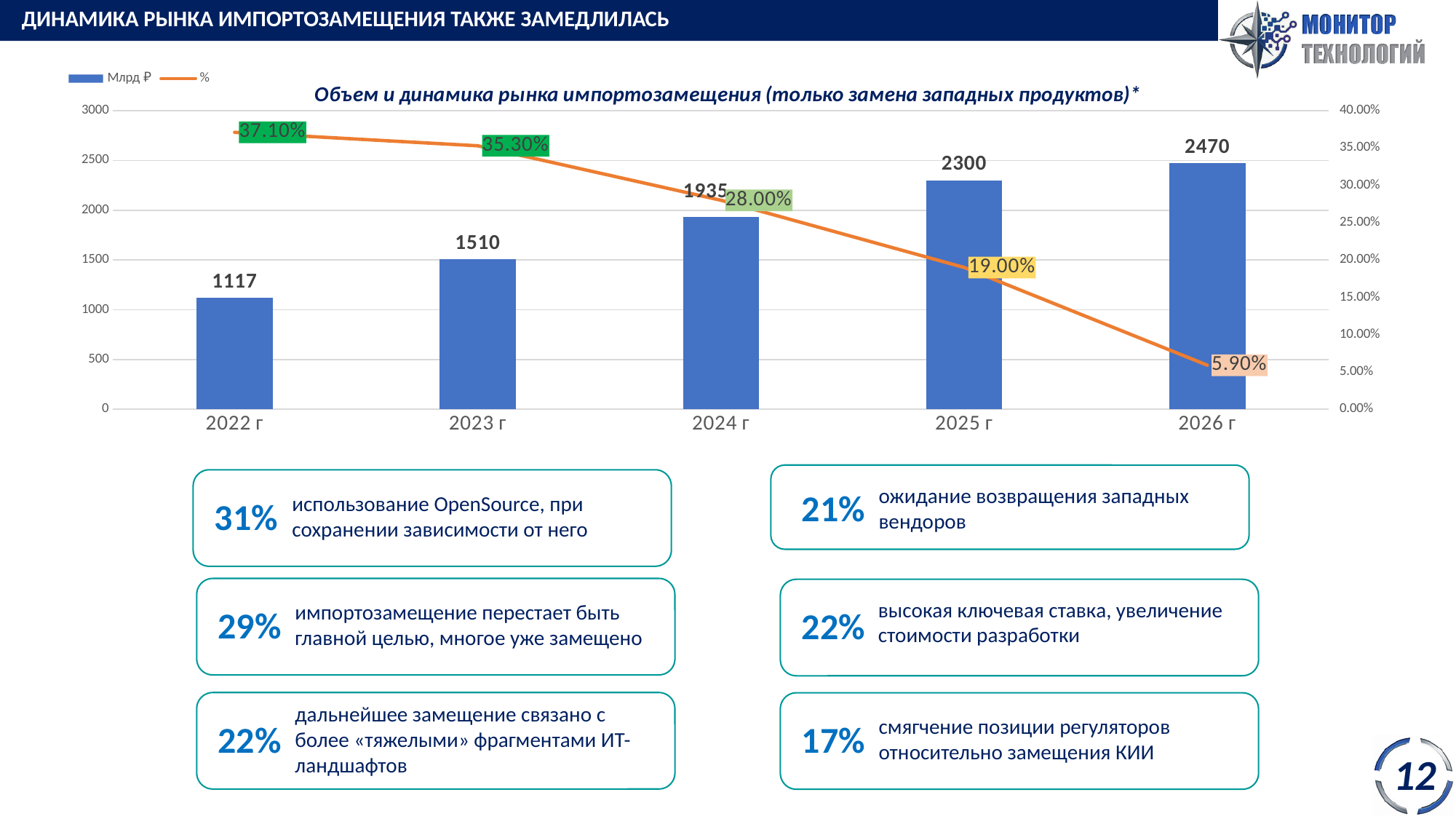
How many years are shown on the x axis? 5 What is the value of the Млрд ₽ bar for 2024 г? 1935 What is the title of the chart? Объем и динамика рынка импортозамещения (только замена западных продуктов)* What percentage does the % line show for 2026 г? 5.90% What is the difference between the Млрд ₽ values for 2025 г and 2023 г? 790 What percentage does the % line show for 2025 г? 19.00% Which year has the lowest value on the % line? 2026 г What is the value of the Млрд ₽ bar for 2022 г? 1117 Which is larger, the % value for 2022 г or for 2023 г? 2022 г How many series does the legend list? 2 Which year has the highest Млрд ₽ bar? 2026 г Do the values on the % line rise or fall from 2022 г to 2026 г? fall